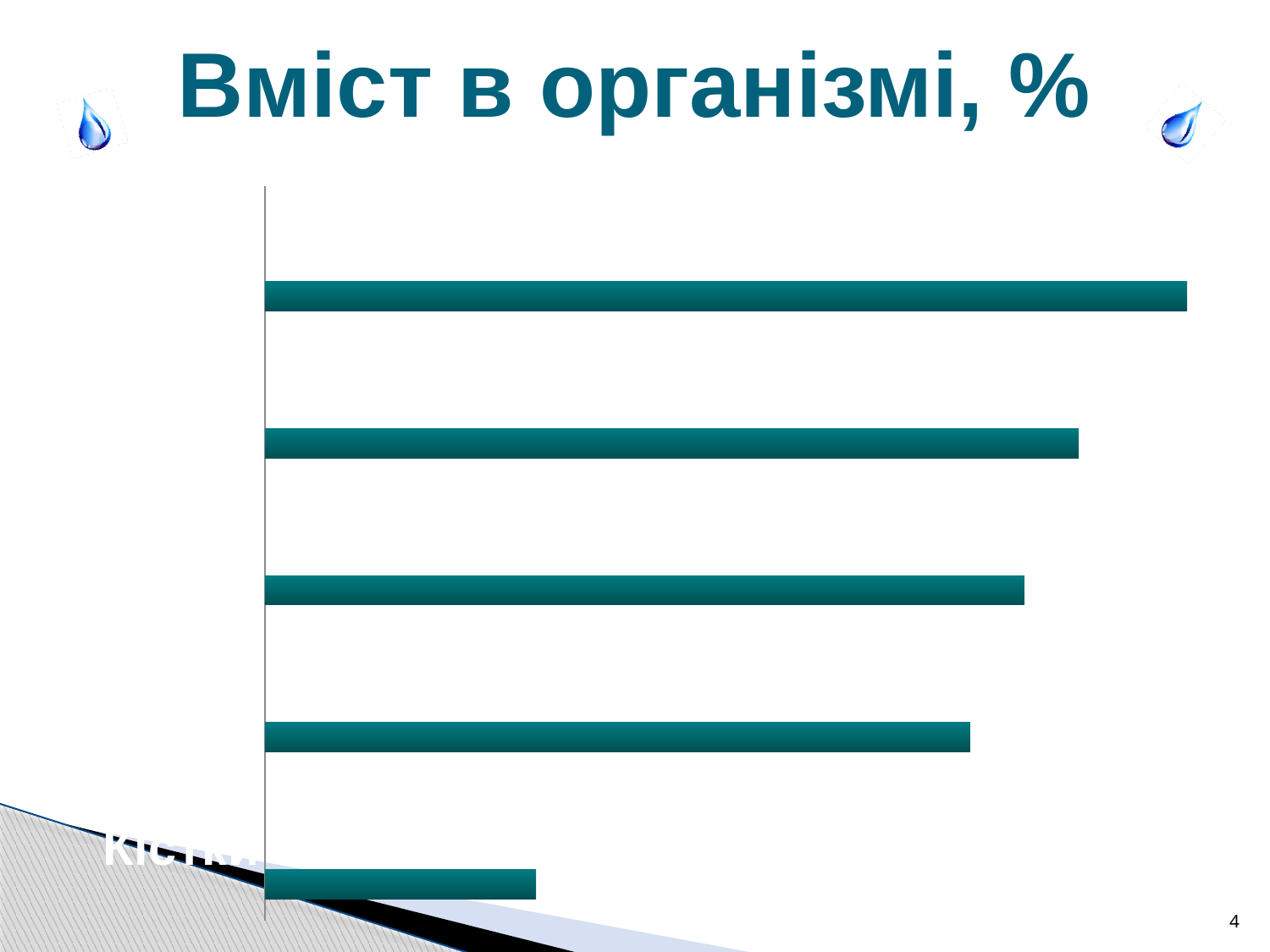
What kind of chart is shown on the slide? bar chart Which bar is the longest in the chart: the top one or the bottom one? the top one What is the title of the slide's chart? Вміст в організмі, % Do the bar lengths increase or decrease going from the top bar to the bottom bar? decrease Is the bottom bar longer or shorter than the fourth bar from the top? shorter Are the bars in the chart oriented horizontally or vertically? horizontally How many bars does the chart contain? 5 Is the second bar from the top longer or shorter than the third bar from the top? longer Which bar is the shortest in the chart: the top one or the bottom one? the bottom one